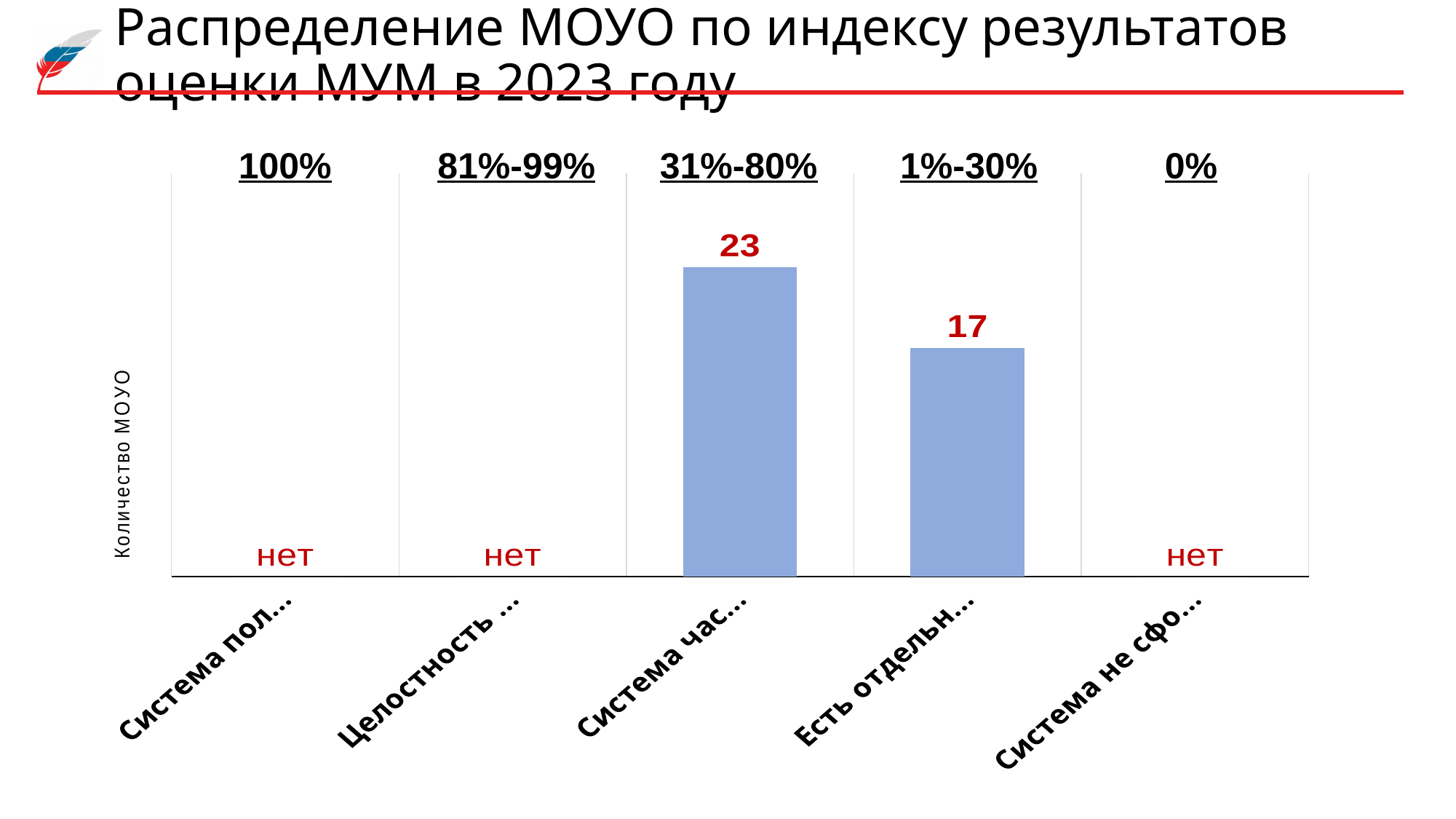
What type of chart is shown on the slide? bar chart Which band has more МОУО, 31%-80% or 1%-30%? 31%-80% How many МОУО fall in the 1%-30% band? 17 What is the label of the vertical axis? Количество МОУО What is the difference between the number of МОУО in the 31%-80% band and the 1%-30% band? 6 Which band has the highest number of МОУО? 31%-80% What is shown for the 0% band? нет How many bands have a bar with a numeric value? 2 What is shown for the 100% band? нет What is the total number of МОУО across the bands with numeric values? 40 How many bands (categories) are shown on the x axis? 5 How many МОУО fall in the 31%-80% band? 23